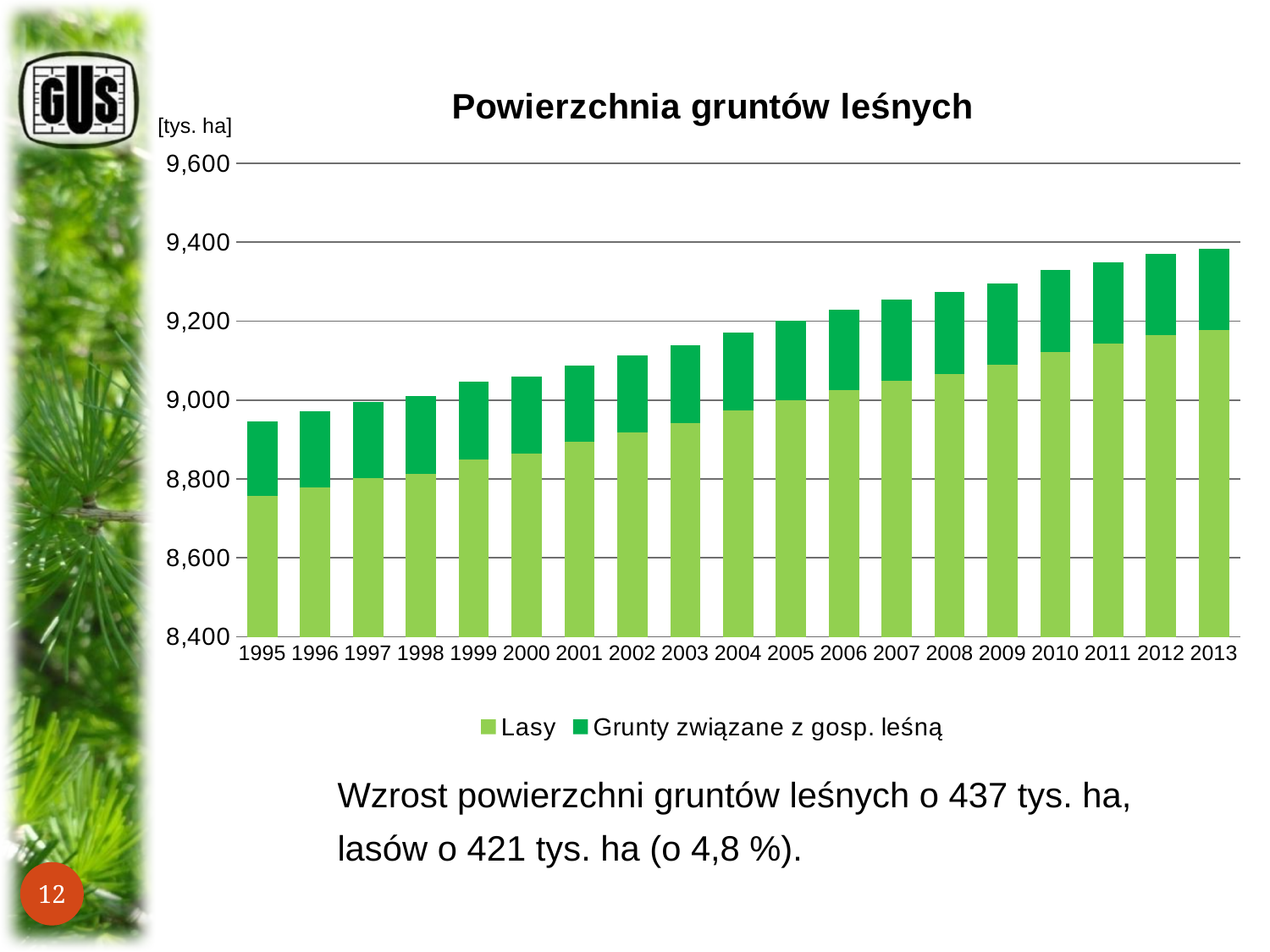
Which year has the highest total bar? 2013 What unit is shown on the vertical axis label? [tys. ha] How many years are shown on the x axis? 19 Which year has the lowest total bar? 1995 What kind of chart is shown on the slide? bar chart Is the total bar for 2000 greater or less than 9,000? greater Is the value for Lasy in 1995 greater or less than 8,800? less Is the total bar for 2013 greater or less than 9,400? less Do the total bar heights rise or fall from 1995 to 2013? rise How many series does the legend list? 2 What is the title of the chart? Powierzchnia gruntów leśnych